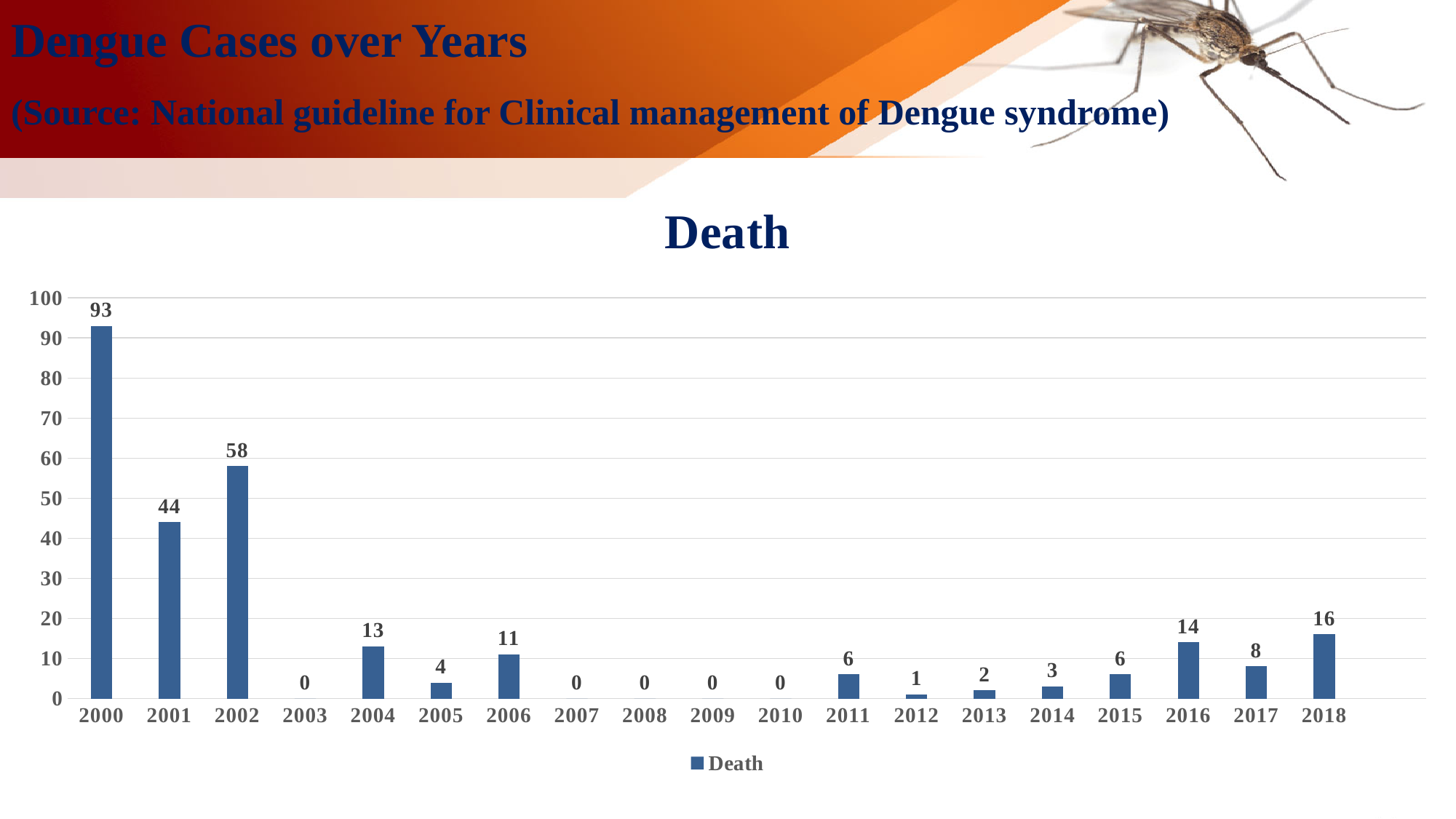
What is the difference in deaths between 2000 and 2001? 49 How many years are shown on the x axis? 19 Is the value for 2002 greater or less than 50? greater What is the number of deaths shown for 2016? 14 Which year has the highest number of deaths? 2000 Which year has more deaths, 2004 or 2006? 2004 What is the title of the chart? Death What is the difference in deaths between 2018 and 2017? 8 What kind of chart is shown on the slide? Bar chart What is the number of deaths shown for 2002? 58 How many years show 0 deaths? 5 What is the number of deaths shown for 2000? 93